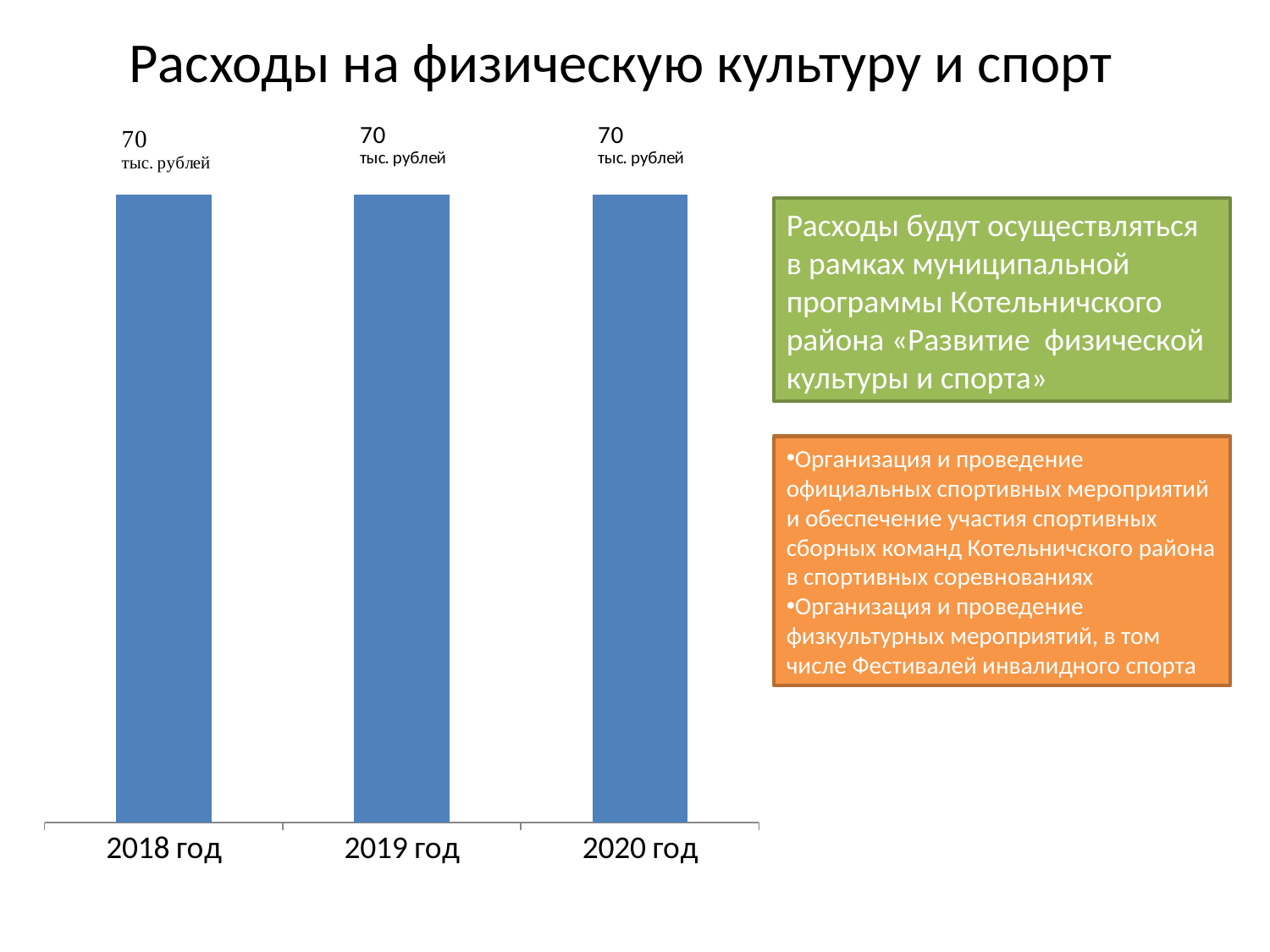
What is the difference between the values for 2018 год and 2020 год? 0 Do the values rise, fall or stay the same from 2018 год to 2020 год? stay the same What is the title of the slide containing the chart? Расходы на физическую культуру и спорт What is the value for 2018 год? 70 тыс. рублей What kind of chart is shown on the slide? bar chart What unit is shown with the data labels on the bars? тыс. рублей Which year is the first category on the x axis? 2018 год Which is larger, the value for 2019 год or the value for 2020 год? they are equal How many categories (years) are shown on the chart? 3 What is the value for 2020 год? 70 тыс. рублей What is the value for 2019 год? 70 тыс. рублей What colour are the bars in the chart? blue